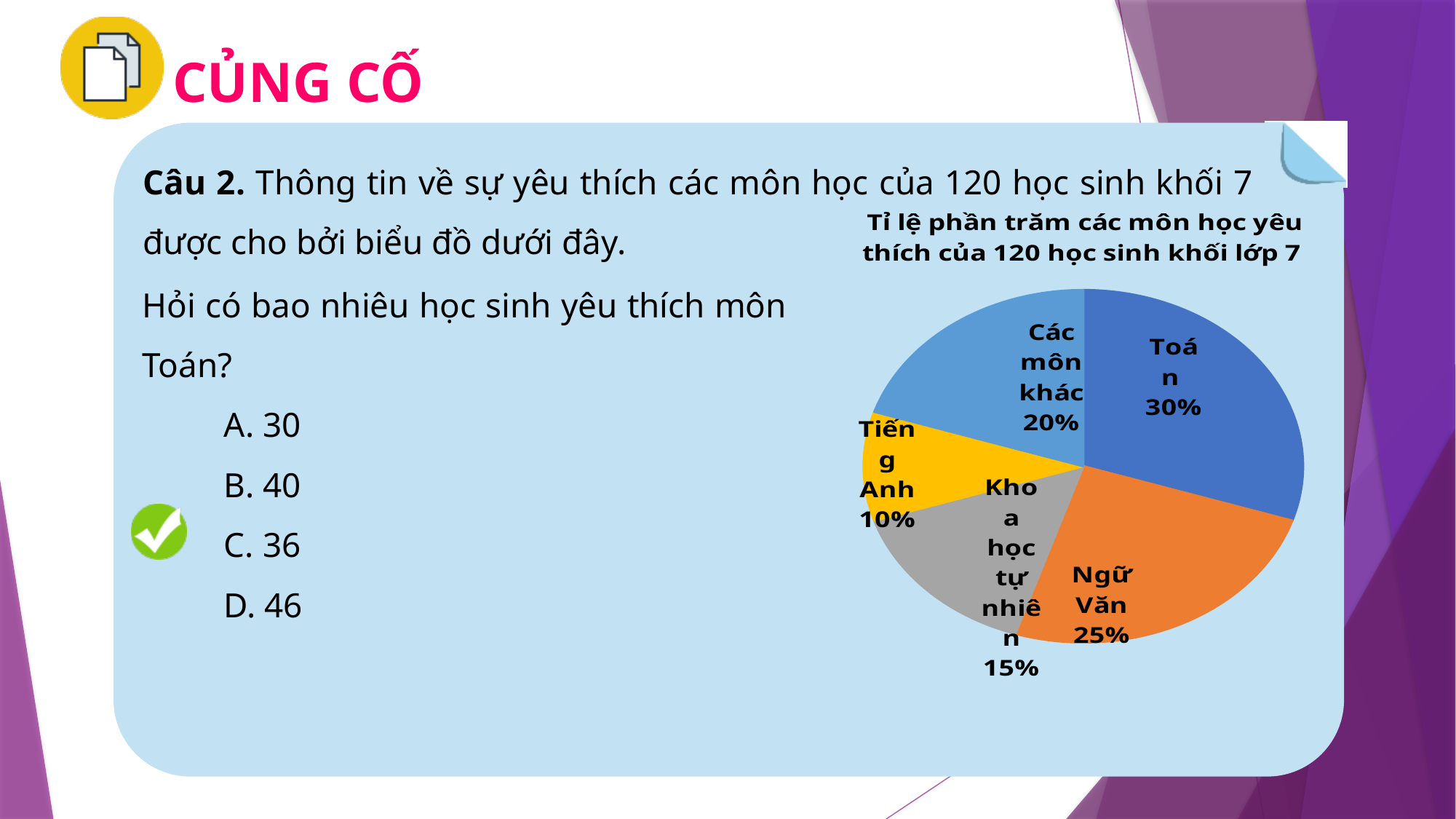
Which subject has the largest slice of the pie chart? Toán What percentage of the pie chart is labelled for Các môn khác? 20% Which slice is larger, Các môn khác or Khoa học tự nhiên? Các môn khác What is the title of the pie chart? Tỉ lệ phần trăm các môn học yêu thích của 120 học sinh khối lớp 7 How many slices does the pie chart have? 5 What percentage of the pie chart is labelled for Khoa học tự nhiên? 15% What percentage of the pie chart is labelled for Toán? 30% What percentage of the pie chart is labelled for Ngữ Văn? 25% Which subject has the smallest slice of the pie chart? Tiếng Anh What kind of chart is shown on the slide? pie chart What is the difference in percentage points between the Toán slice and the Ngữ Văn slice? 5% What percentage of the pie chart is labelled for Tiếng Anh? 10%